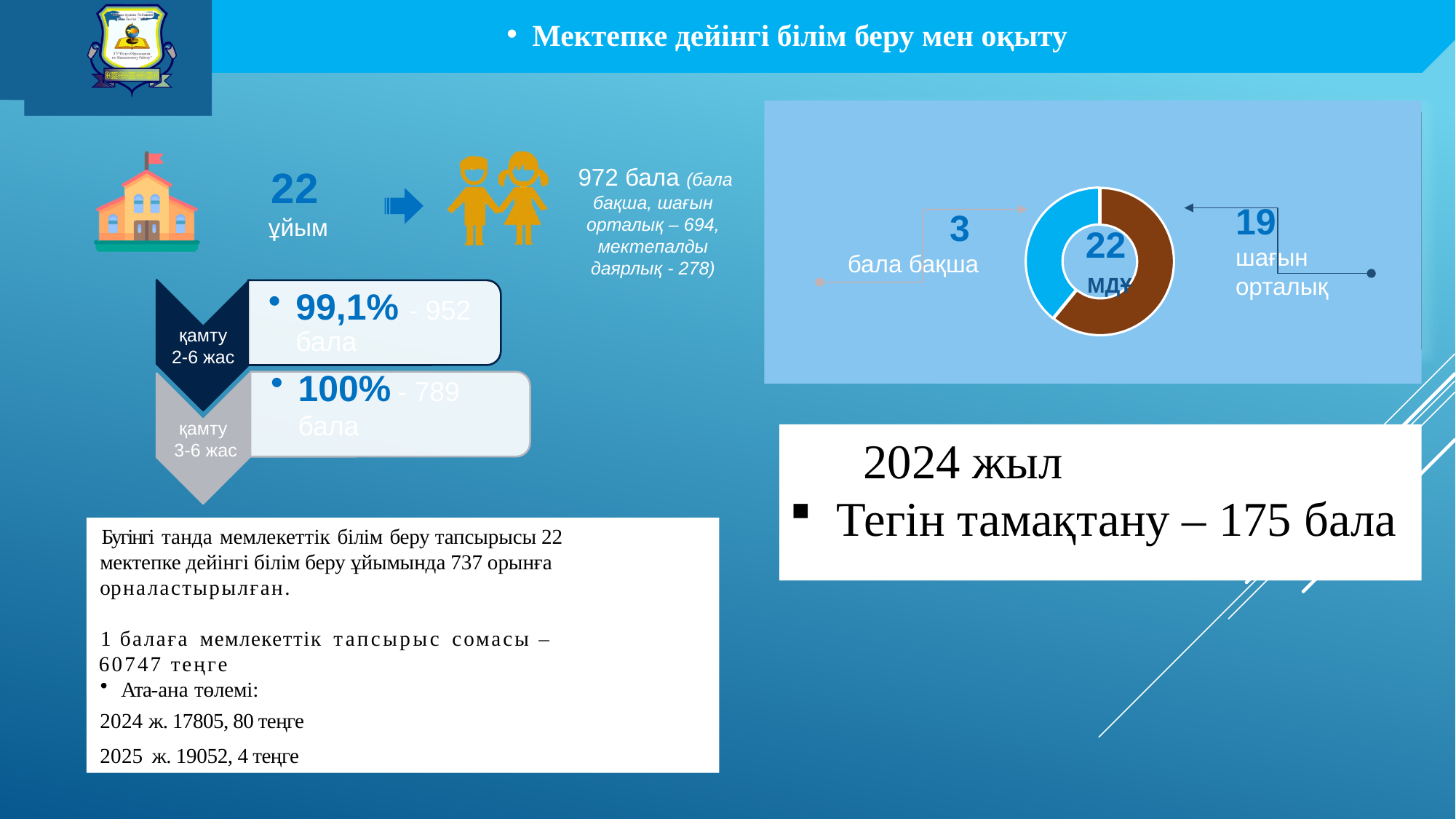
Which category in the donut chart is the smallest? бала бақша In the donut chart, how many шағын орталық are shown? 19 In the donut chart, how many бала бақша are shown? 3 Is the value for шағын орталық in the donut chart greater or less than 10? greater Which category in the donut chart is the largest? шағын орталық What is the difference between the number of шағын орталық and the number of бала бақша in the donut chart? 16 What colour is the шағын орталық segment of the donut chart? Brown What colour is the бала бақша segment of the donut chart? Light blue What total number is printed in the centre of the donut chart? 22 МДҰ Which category in the donut chart has the larger value, бала бақша or шағын орталық? шағын орталық How many categories does the donut chart show? 2 What kind of chart is shown on the right side of the slide? Donut (pie) chart